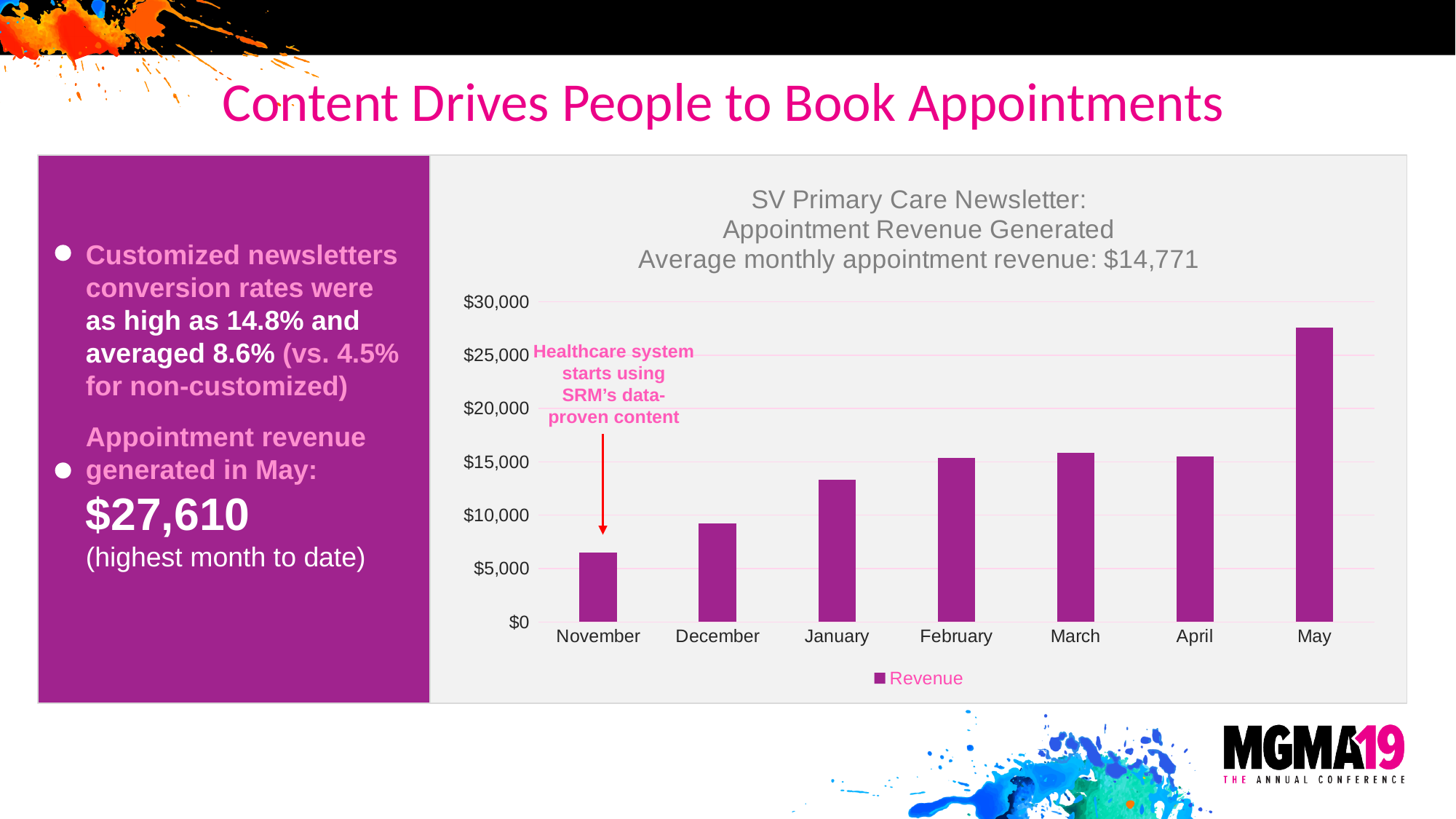
According to the chart title, what is the average monthly appointment revenue? $14,771 Which month has higher revenue, December or January? January What kind of chart is shown on the slide? bar chart Which month has the lowest appointment revenue in the chart? November Which month has the highest appointment revenue in the chart? May How many series does the chart legend list? 1 What is the name of the series shown in the chart legend? Revenue Is the revenue for November greater or less than $10,000? less Is the revenue for January greater or less than $10,000? greater Is the revenue for May greater or less than $25,000? greater How many months are plotted on the x axis of the chart? 7 Do the revenue values generally rise or fall from November to May? rise